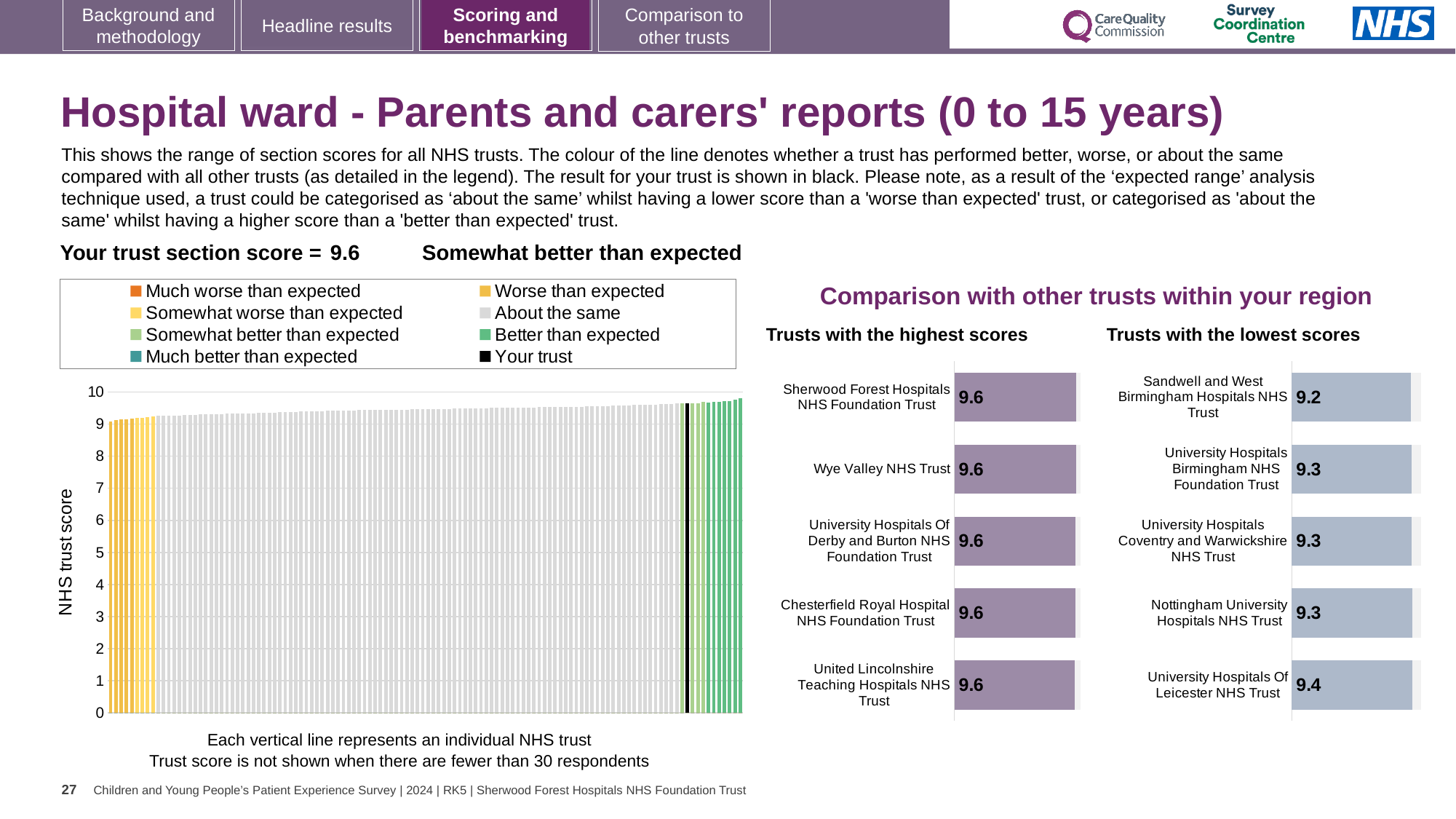
What kind of chart is the large chart on the left showing NHS trust scores? Bar chart In the 'Trusts with the lowest scores' chart, which trust has the lowest score? Sandwell and West Birmingham Hospitals NHS Trust How many entries does the legend of the large chart on the left list? 8 Comparing the two right-hand charts, what is the difference between the score for Sherwood Forest Hospitals NHS Foundation Trust and the score for Sandwell and West Birmingham Hospitals NHS Trust? 0.4 In the 'Trusts with the lowest scores' chart, what is the score for University Hospitals Of Leicester NHS Trust? 9.4 In the 'Trusts with the highest scores' chart, what is the score for Wye Valley NHS Trust? 9.6 In the 'Trusts with the lowest scores' chart, which has the larger score: University Hospitals Birmingham NHS Foundation Trust or Sandwell and West Birmingham Hospitals NHS Trust? University Hospitals Birmingham NHS Foundation Trust In the 'Trusts with the lowest scores' chart, which trust has the highest score? University Hospitals Of Leicester NHS Trust In the 'Trusts with the lowest scores' chart, what is the difference between the scores of University Hospitals Of Leicester NHS Trust and Sandwell and West Birmingham Hospitals NHS Trust? 0.2 In the 'Trusts with the lowest scores' chart, what is the score for Sandwell and West Birmingham Hospitals NHS Trust? 9.2 How many trusts are shown in the 'Trusts with the highest scores' chart? 5 In the large chart on the left, do the trust scores rise or fall from left to right along the x axis? Rise